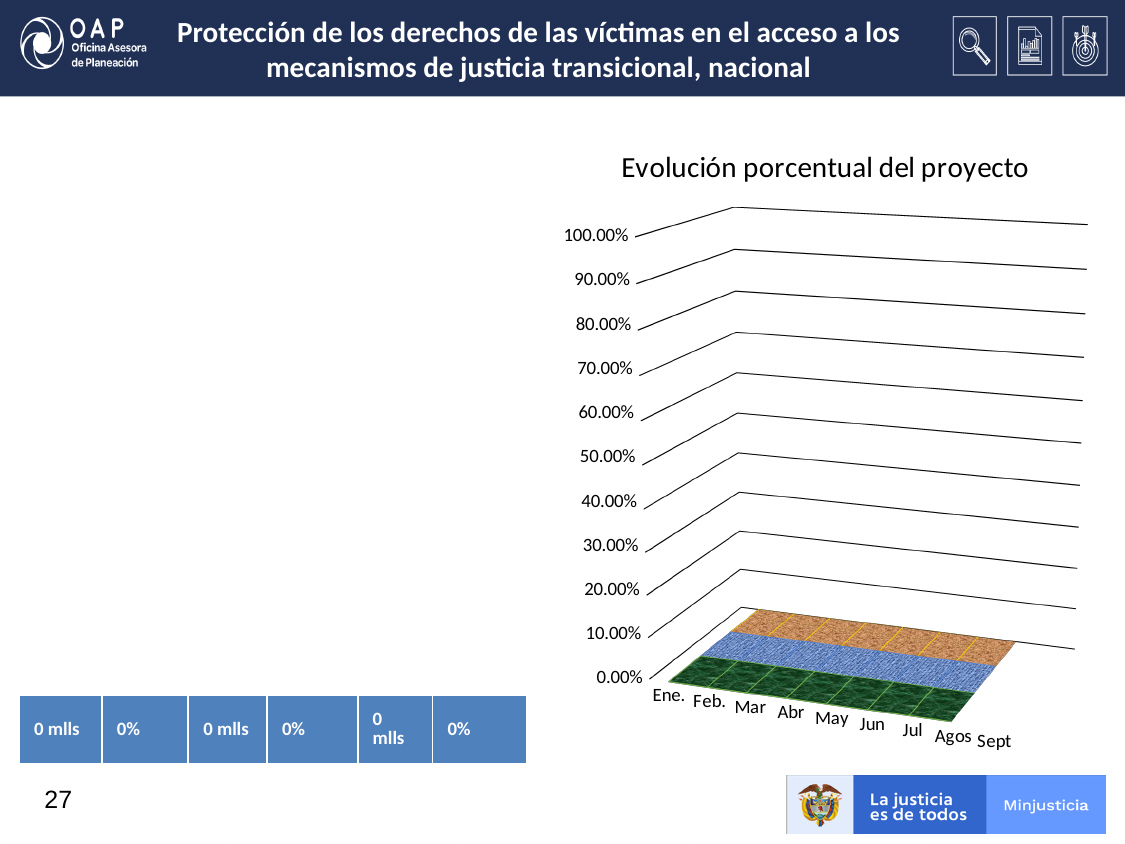
What is the title of the chart on the slide? Evolución porcentual del proyecto Is the plotted value for Mar greater or less than 10.00%? less What is the first category on the x axis of the chart? Ene. How many months are shown along the x axis of the chart? 9 Do the plotted values rise, fall, or stay flat from Ene. to Sept? stay flat What is the lowest tick value shown on the vertical axis of the chart? 0.00% What kind of chart is shown on the slide? 3D line chart What is the highest tick value shown on the vertical axis of the chart? 100.00%